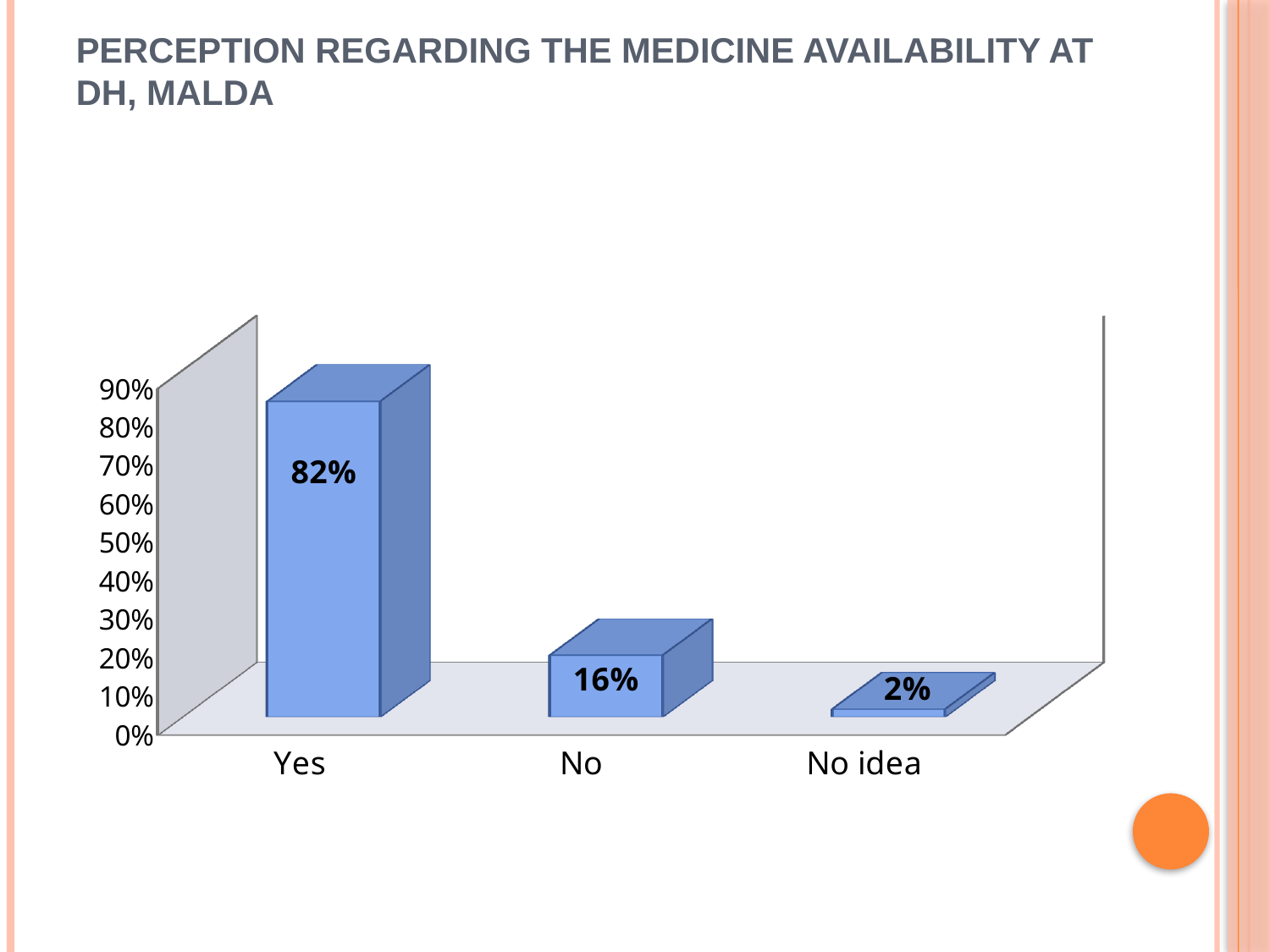
What is the difference between the values for No and No idea? 14% Is the value for Yes greater or less than 50%? greater Which category has the lowest value? No idea What is the value for No idea? 2% Which category has the highest value? Yes What kind of chart is shown on the slide? bar chart What is the value for Yes? 82% Which is larger, the value for No or the value for No idea? No How many categories are shown on the x axis? 3 What is the value for No? 16% Do the values rise or fall from left to right along the x axis? fall What is the difference between the values for Yes and No? 66%